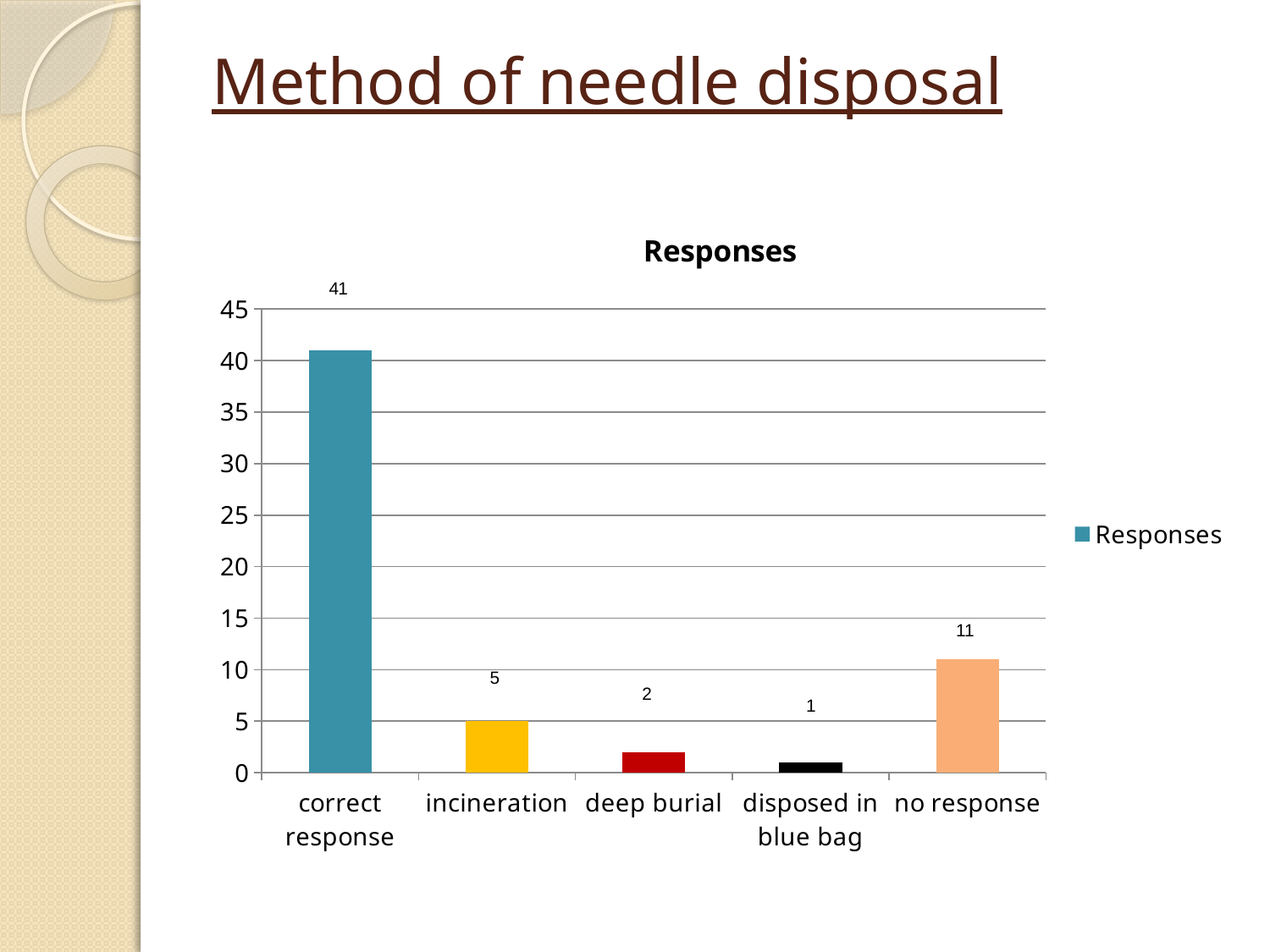
What is the value for no response? 11 What kind of chart is shown? bar chart What is the value for incineration? 5 Which category has the highest value? correct response What is the title of the chart? Responses How many categories are shown on the x axis? 5 What is the difference between the values for correct response and no response? 30 What is the value for correct response? 41 What is the value for disposed in blue bag? 1 Which category has the lowest value? disposed in blue bag Is the value for no response greater or less than 10? greater Which is larger, the value for incineration or the value for deep burial? incineration